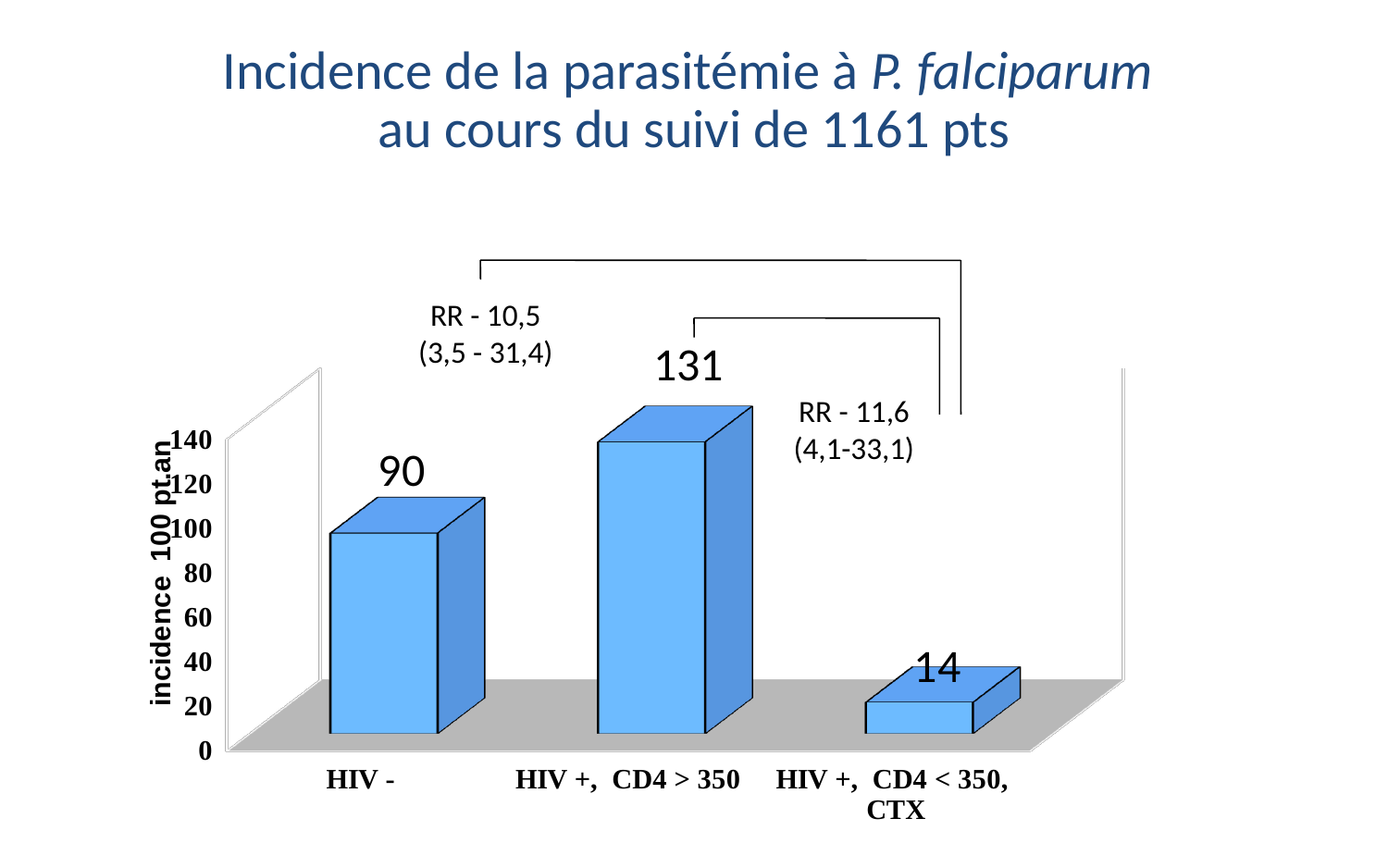
What is the incidence value for the HIV +, CD4 < 350, CTX group? 14 What is the difference in incidence between the HIV +, CD4 > 350 group and the HIV - group? 41 How many groups are shown on the x axis? 3 Which group has the highest incidence? HIV +, CD4 > 350 What kind of chart is shown on the slide? bar chart What is the difference in incidence between the HIV - group and the HIV +, CD4 < 350, CTX group? 76 Is the incidence for the HIV - group greater or less than 100? less What is the incidence value for the HIV +, CD4 > 350 group? 131 Which group has the lowest incidence? HIV +, CD4 < 350, CTX Which has a higher incidence, HIV - or HIV +, CD4 > 350? HIV +, CD4 > 350 What is the label of the y axis? incidence 100 pt.an What is the incidence value for the HIV - group? 90